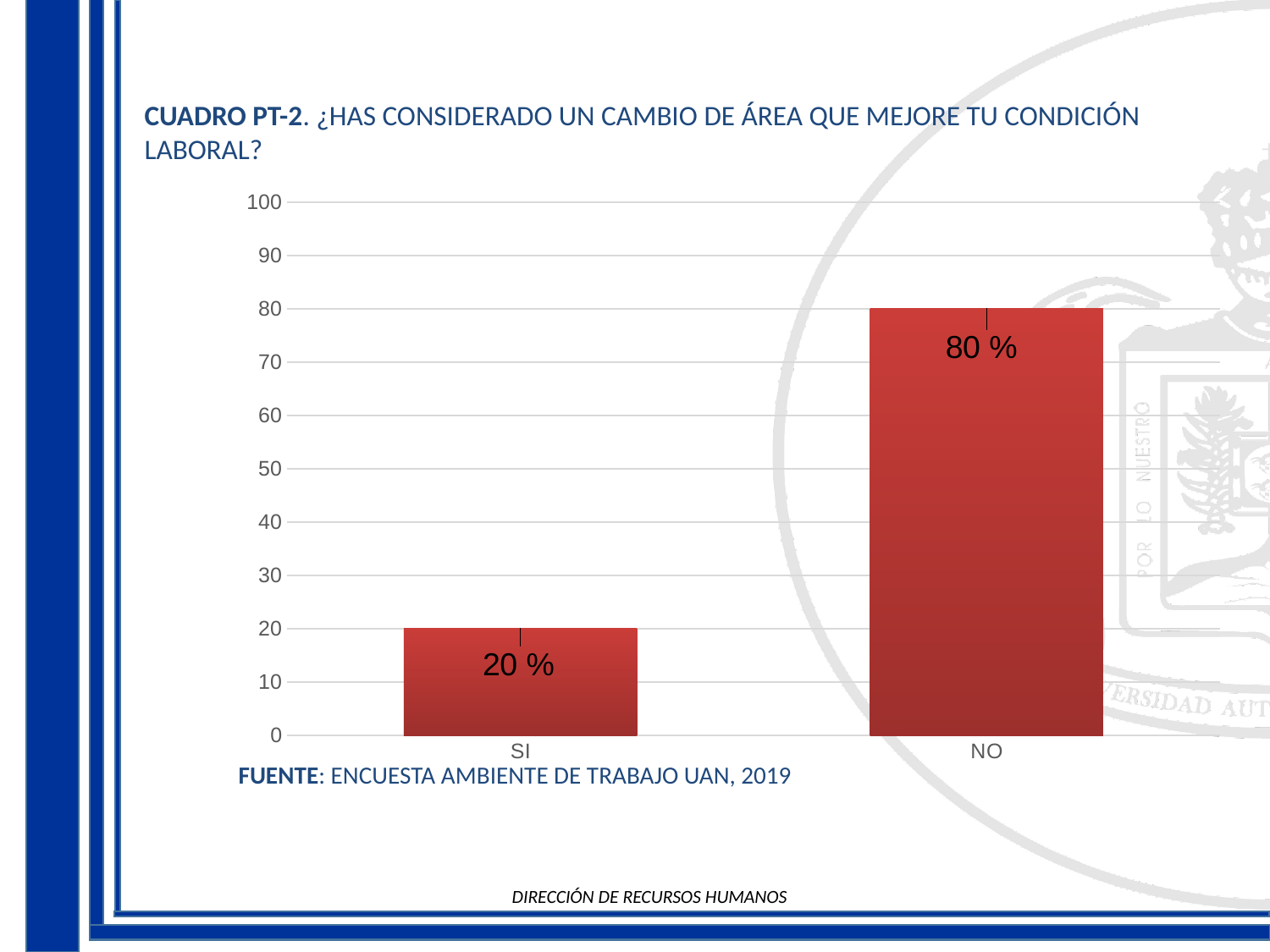
Is the value for SI greater or less than 30? less What is the difference between the values for NO and SI? 60 % How many categories are shown on the x axis? 2 What is the maximum value shown on the y axis? 100 Which is larger, the value for SI or the value for NO? NO Is the value for NO greater or less than 50? greater What kind of chart is shown on the slide? bar chart What is the value for NO? 80 % What source is cited below the chart? ENCUESTA AMBIENTE DE TRABAJO UAN, 2019 What is the value for SI? 20 % Which category has the lowest value? SI Which category has the highest value? NO